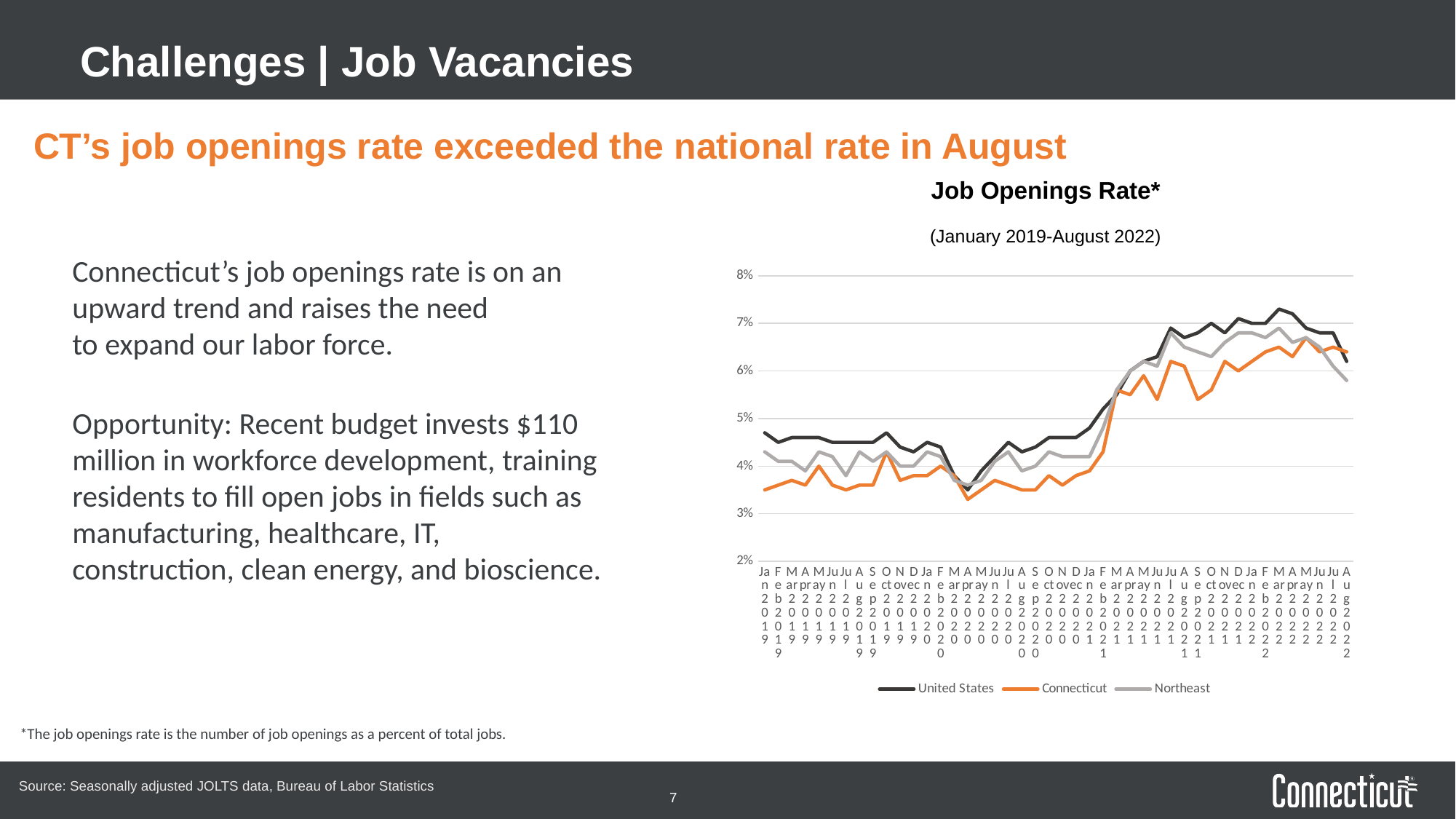
What colour is the Connecticut line in the Job Openings Rate chart? Orange Is the highest point of the United States line greater or less than 7%? greater Which series are listed in the legend of the Job Openings Rate chart? United States, Connecticut, Northeast Which series has the lowest job openings rate for most of 2019? Connecticut What kind of chart is shown on the slide? Line chart Is the United States job openings rate at the start of the chart (January 2019) greater or less than 4%? greater Overall, does the Connecticut job openings rate rise or fall from January 2019 to August 2022? Rise Is the lowest point of the Connecticut line greater or less than 4%? less At the start of the chart (January 2019), which is higher: the United States rate or the Connecticut rate? United States How many series does the legend of the Job Openings Rate chart list? 3